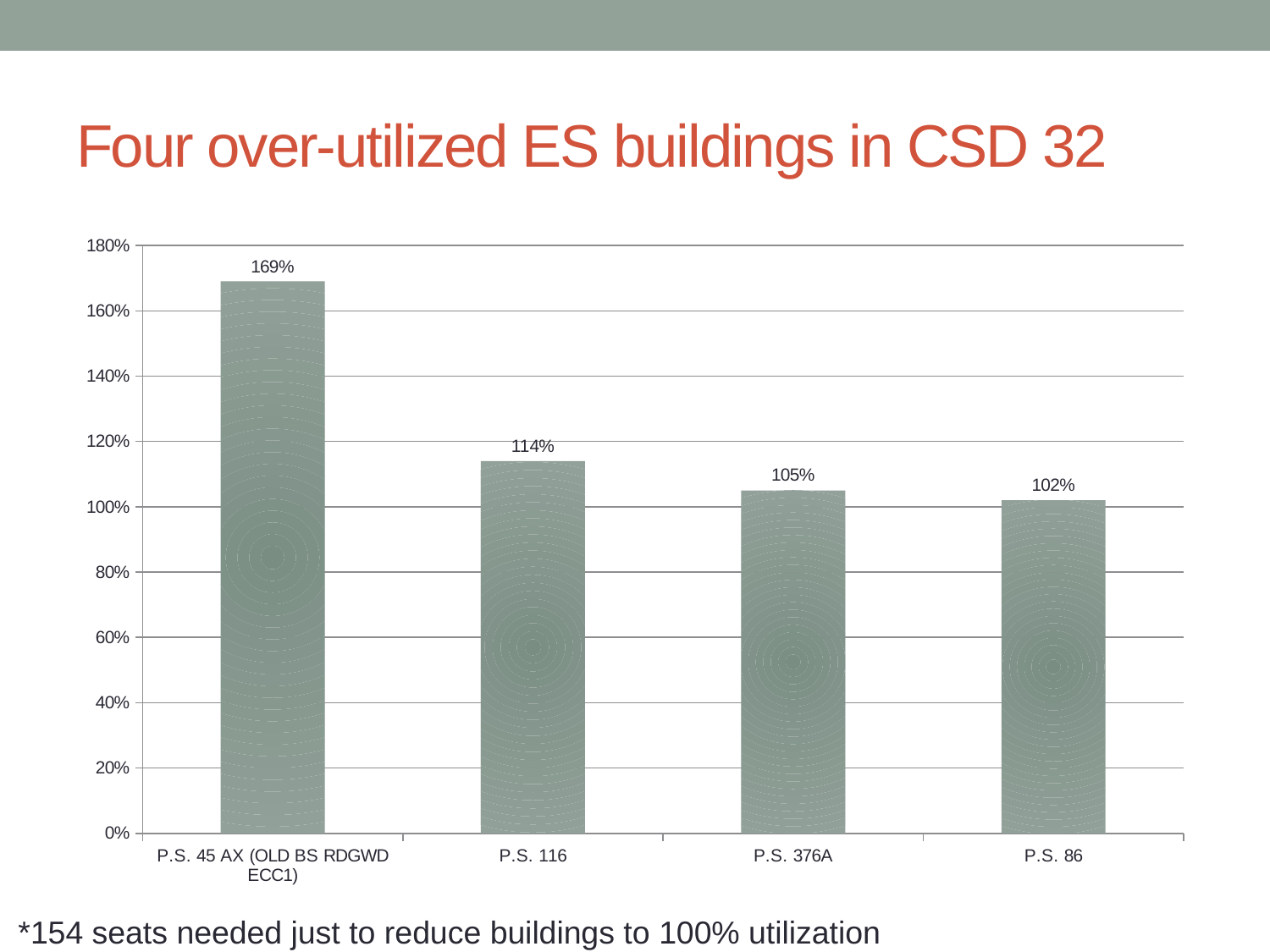
How many buildings are shown in the chart? 4 What is the utilization value for P.S. 116? 114% What is the difference between the utilization of P.S. 376A and P.S. 86? 3% Do the values rise or fall from left to right across the chart? Fall Which has a higher utilization, P.S. 116 or P.S. 376A? P.S. 116 Which building has the lowest utilization? P.S. 86 Is the value for P.S. 45 AX (OLD BS RDGWD ECC1) greater or less than 160%? greater What kind of chart is shown on the slide? Bar chart What is the utilization value for P.S. 376A? 105% What is the difference between the utilization of P.S. 45 AX (OLD BS RDGWD ECC1) and P.S. 116? 55% Which building has the highest utilization? P.S. 45 AX (OLD BS RDGWD ECC1) What is the utilization value for P.S. 86? 102%